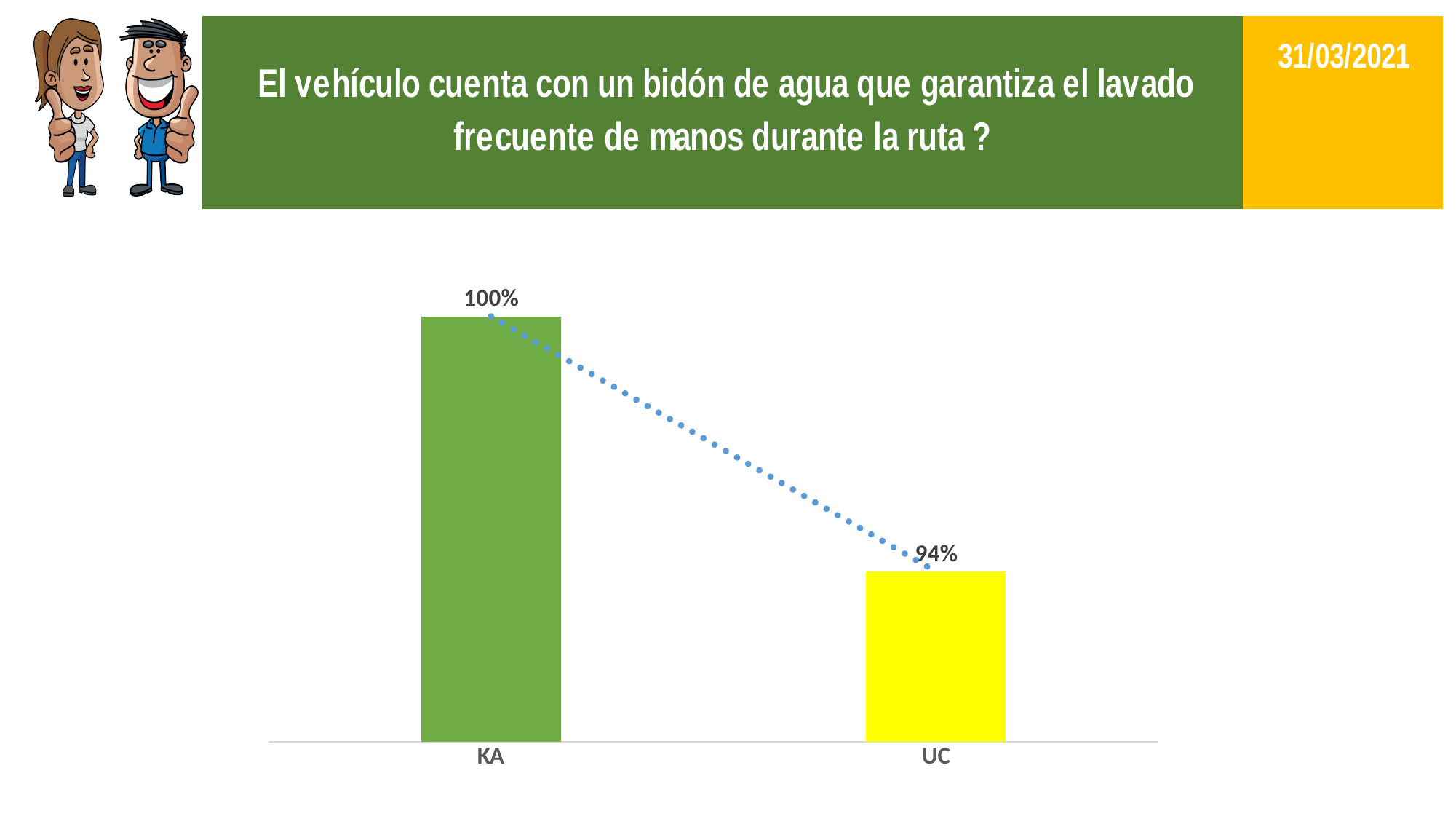
What colour is the bar for UC? Yellow What colour is the bar for KA? Green What is the value for UC? 94% Which is larger, the value for KA or the value for UC? KA What is the difference between the values for KA and UC? 6% How many categories are shown on the x axis? 2 Do the values rise or fall from KA to UC? Fall Which category has the highest value? KA What kind of chart is shown on the slide? Bar chart What is the value for KA? 100% Which category has the lowest value? UC